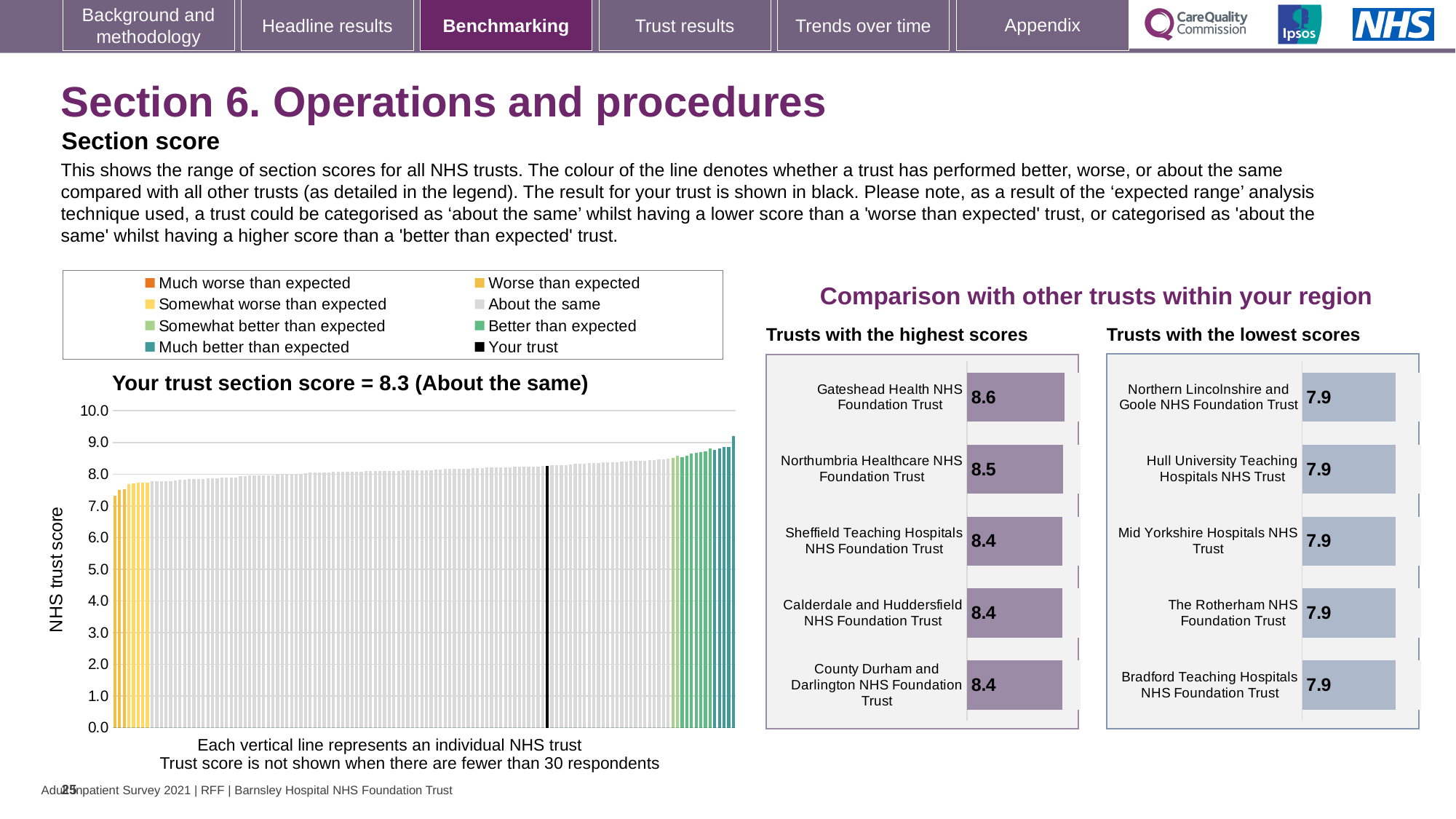
In the 'Trusts with the highest scores' chart, what is the difference between the scores of Gateshead Health NHS Foundation Trust and Northumbria Healthcare NHS Foundation Trust? 0.1 In the 'Your trust section score' chart, what is the label on the vertical axis? NHS trust score In the 'Trusts with the lowest scores' chart, what is the score for Hull University Teaching Hospitals NHS Trust? 7.9 In the 'Trusts with the highest scores' chart, how many trusts are shown? 5 Which is larger: the score for Gateshead Health NHS Foundation Trust in the 'Trusts with the highest scores' chart or the score for Mid Yorkshire Hospitals NHS Trust in the 'Trusts with the lowest scores' chart? Gateshead Health NHS Foundation Trust In the 'Your trust section score' chart, how many entries does the legend list? 8 In the 'Trusts with the highest scores' chart, what is the score for Gateshead Health NHS Foundation Trust? 8.6 In the 'Your trust section score' chart, is the value of the lowest-scoring trust greater or less than 8.0? less In the 'Trusts with the highest scores' chart, which trust has the highest score? Gateshead Health NHS Foundation Trust In the 'Your trust section score' chart, do the bars rise or fall from left to right? rise In the 'Your trust section score' chart, what kind of chart is shown? bar chart In the 'Your trust section score' chart, what is the section score for your trust? 8.3